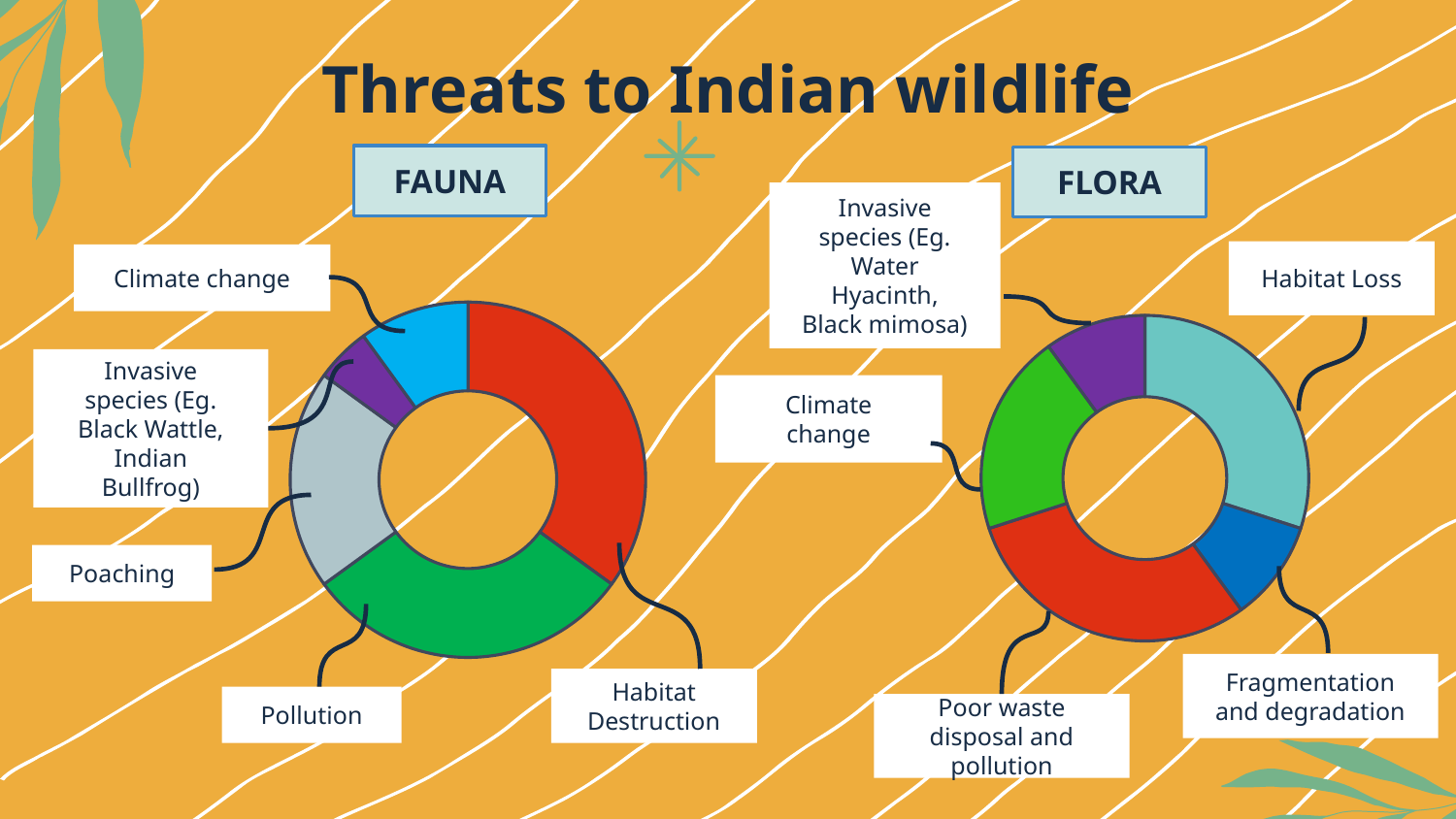
In the FAUNA chart, which slice is larger: Pollution or Invasive species? Pollution In the FAUNA chart, which threat has the smallest slice? Invasive species (Eg. Black Wattle, Indian Bullfrog) In the FAUNA chart, which slice is larger: Habitat Destruction or Climate change? Habitat Destruction How many categories does the FAUNA chart show? 5 How many categories does the FLORA chart show? 5 What kind of chart is the FAUNA chart? Pie chart (donut) In the FAUNA chart, which threat has the largest slice? Habitat Destruction In the FLORA chart, which slice is larger: Climate change or Invasive species? Climate change In the FLORA chart, which threat has the largest slice? Habitat Loss and Poor waste disposal and pollution (tied) What kind of chart is the FLORA chart? Pie chart (donut) What is the title of the slide containing the two charts? Threats to Indian wildlife In the FLORA chart, what colour is the Habitat Loss slice? Teal